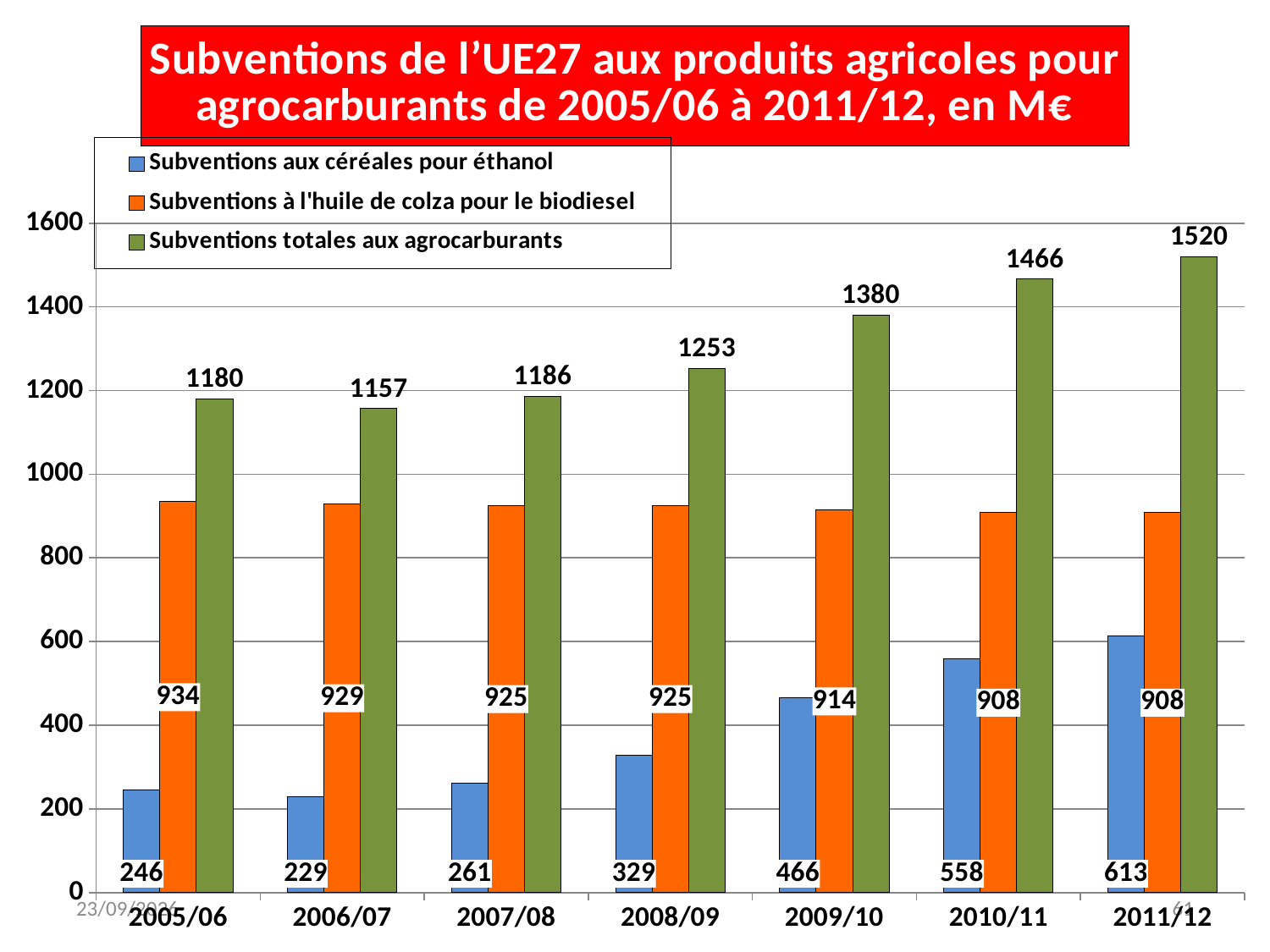
What is the value of 'Subventions totales aux agrocarburants' for 2008/09? 1253 Which year has the lowest value for 'Subventions aux céréales pour éthanol'? 2006/07 Do the values for 'Subventions à l'huile de colza pour le biodiesel' rise or fall from 2005/06 to 2011/12? fall How many years are shown on the x axis? 7 Which is larger: 'Subventions à l'huile de colza pour le biodiesel' in 2005/06 or in 2011/12? 2005/06 Which year has the highest value for 'Subventions totales aux agrocarburants'? 2011/12 How many series does the legend list? 3 What kind of chart is shown on the slide? bar chart What is the value of 'Subventions aux céréales pour éthanol' for 2009/10? 466 What is the value of 'Subventions à l'huile de colza pour le biodiesel' for 2005/06? 934 Is the value for 'Subventions aux céréales pour éthanol' in 2011/12 greater or less than 600? greater What is the difference between 'Subventions totales aux agrocarburants' in 2011/12 and in 2005/06? 340